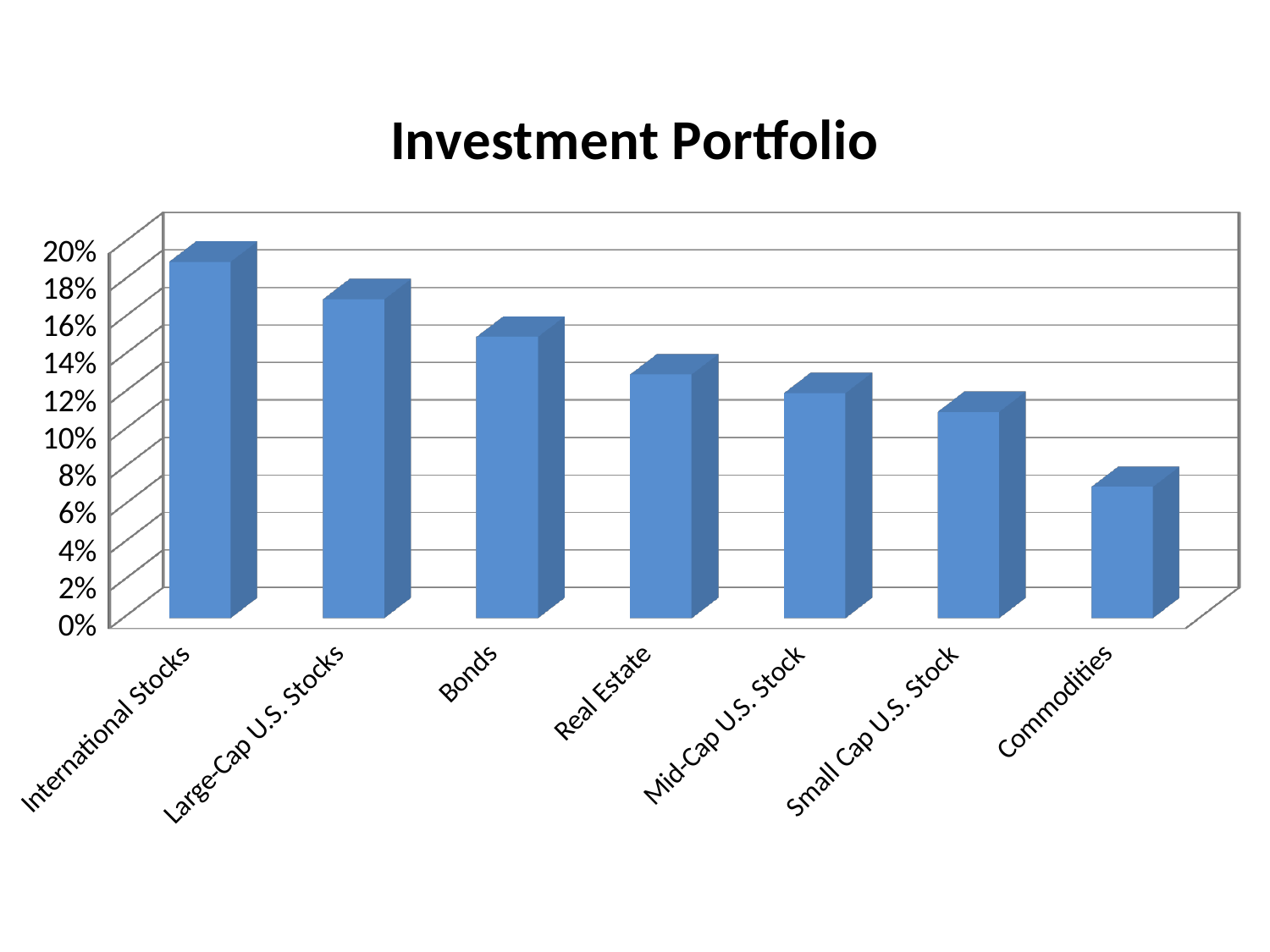
Which is larger, the value for Commodities or the value for Mid-Cap U.S. Stock? Mid-Cap U.S. Stock Is the value for Commodities greater or less than 10%? less What is the title of the chart? Investment Portfolio Which category has the lowest value? Commodities Is the value for International Stocks greater or less than 16%? greater Is the value for Small Cap U.S. Stock greater or less than 14%? less How many categories are plotted in the chart? 7 Which category has the highest value? International Stocks What kind of chart is shown on the slide? Bar chart Which is larger, the value for Large-Cap U.S. Stocks or the value for Real Estate? Large-Cap U.S. Stocks Do the values rise or fall moving from left to right along the x axis? Fall